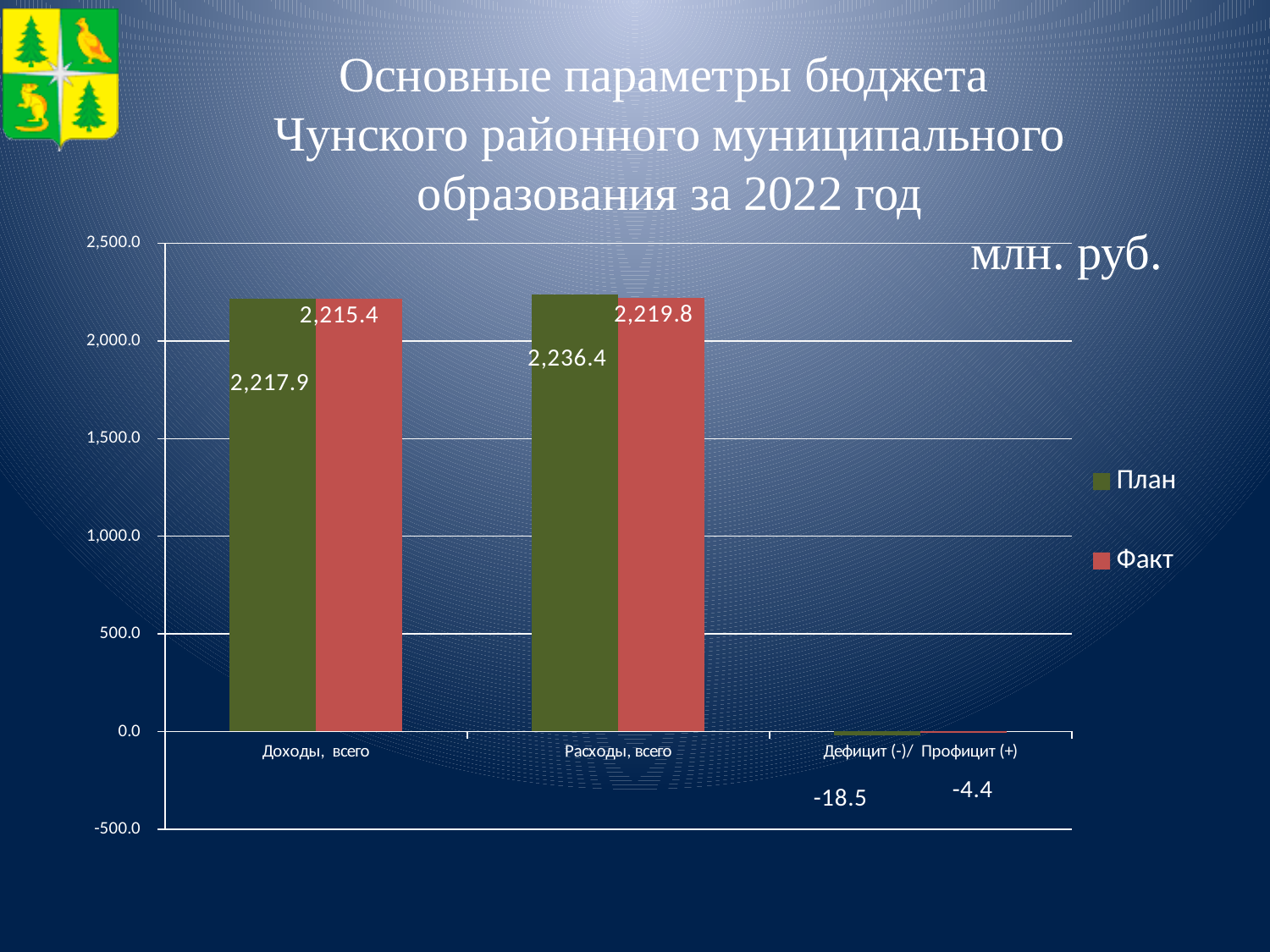
Which category has the lowest Факт value? Дефицит (-)/ Профицит (+) Which category has the highest План value? Расходы, всего How many categories are shown on the x axis? 3 What is the План value for Доходы, всего? 2,217.9 What kind of chart is shown on the slide? Bar chart What is the Факт value for Дефицит (-)/ Профицит (+)? -4.4 What is the Факт value for Расходы, всего? 2,219.8 How many series does the legend list? 2 What is the План value for Дефицит (-)/ Профицит (+)? -18.5 Which is larger for Доходы, всего: the План value or the Факт value? План What is the difference between the План values for Расходы, всего and Доходы, всего? 18.5 What is the difference between the План and Факт values for Расходы, всего? 16.6